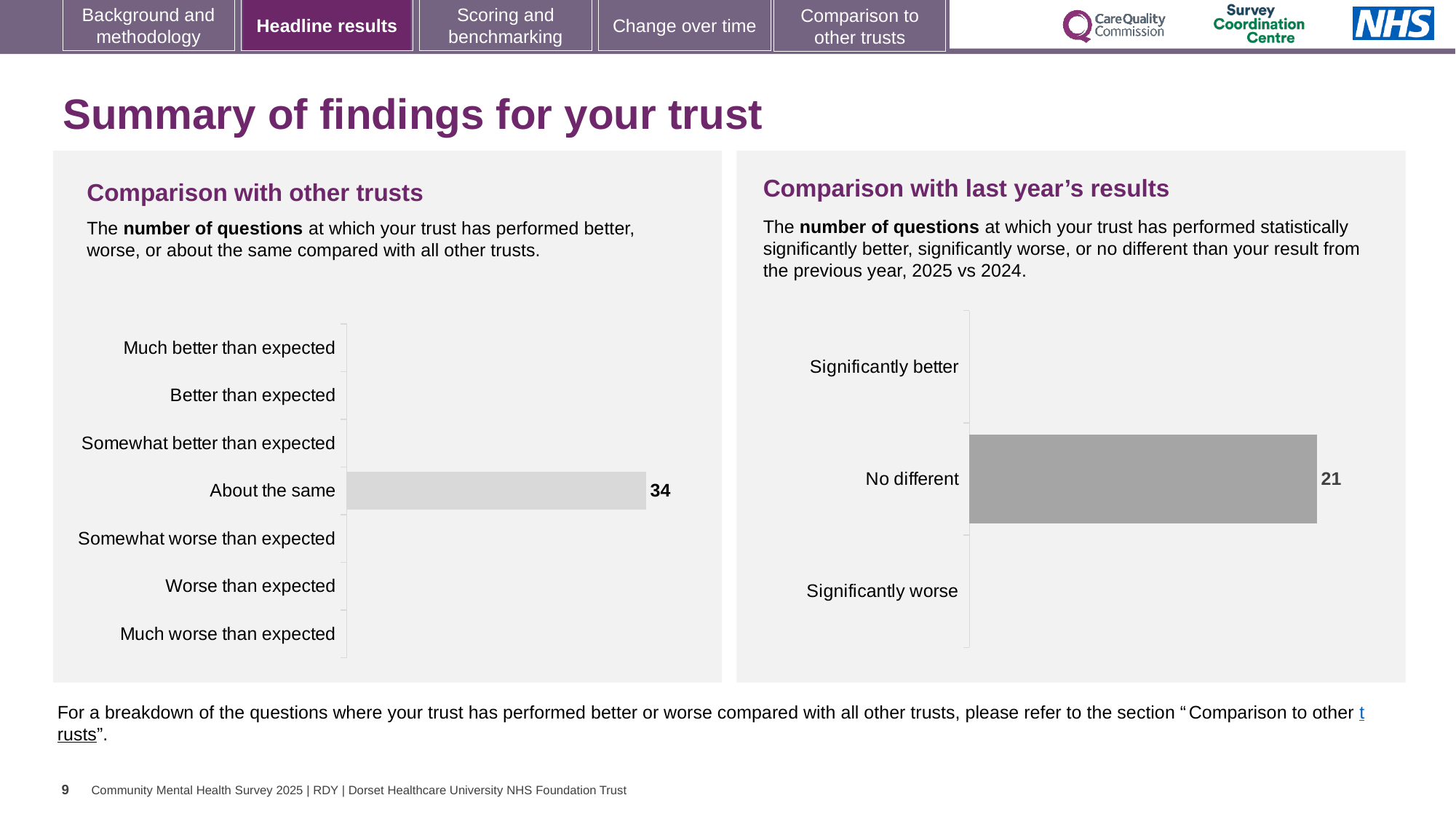
Which is larger: the 'About the same' value in the left chart or the 'No different' value in the right chart? About the same What is the top category label on the 'Comparison with other trusts' chart? Much better than expected In the 'Comparison with other trusts' chart, which category has the highest value? About the same What kind of chart is the 'Comparison with other trusts' chart? Bar chart What is the title of the chart on the right side of the slide? Comparison with last year's results What is the difference between the 'About the same' value in the left chart and the 'No different' value in the right chart? 13 How many categories are listed on the 'Comparison with last year's results' chart? 3 How many categories are listed on the 'Comparison with other trusts' chart? 7 In the 'Comparison with last year's results' chart, which category has the highest value? No different In the 'Comparison with last year's results' chart, what is the value for 'No different'? 21 In the 'Comparison with other trusts' chart, what is the value for 'About the same'? 34 What kind of chart is the 'Comparison with last year's results' chart? Bar chart